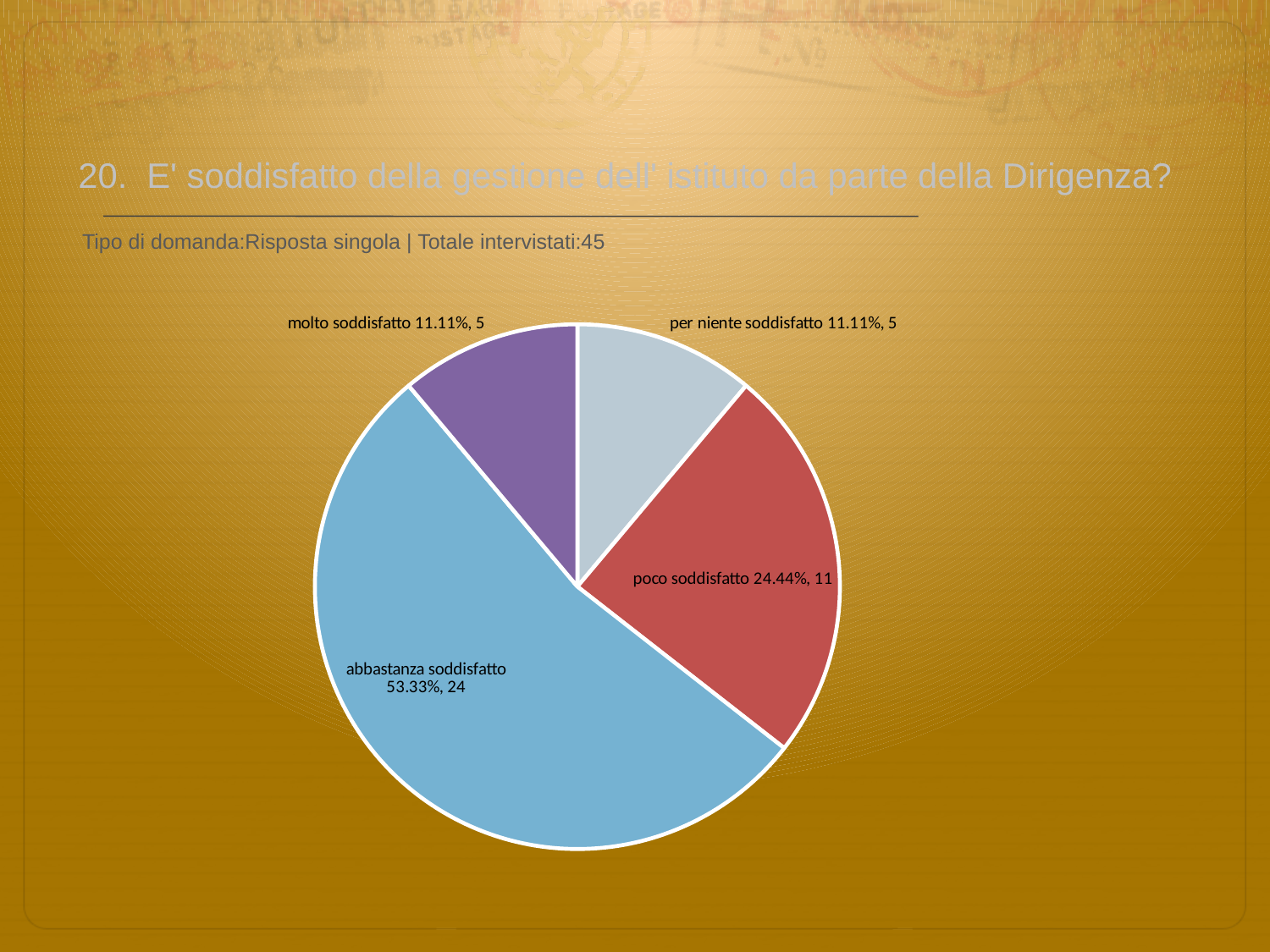
What is the count for 'per niente soddisfatto'? 5 What is the count for 'abbastanza soddisfatto'? 24 What percentage share does 'molto soddisfatto' have? 11.11% Which is larger, the count for 'poco soddisfatto' or the count for 'molto soddisfatto'? poco soddisfatto What is the difference in count between 'abbastanza soddisfatto' and 'poco soddisfatto'? 13 How many slices does the pie chart have? 4 What percentage share does 'poco soddisfatto' have? 24.44% What is the total number of respondents across all slices? 45 Which category has the largest slice? abbastanza soddisfatto What colour is the 'abbastanza soddisfatto' slice? blue What is the percentage share of 'abbastanza soddisfatto'? 53.33% What kind of chart is shown on the slide? pie chart